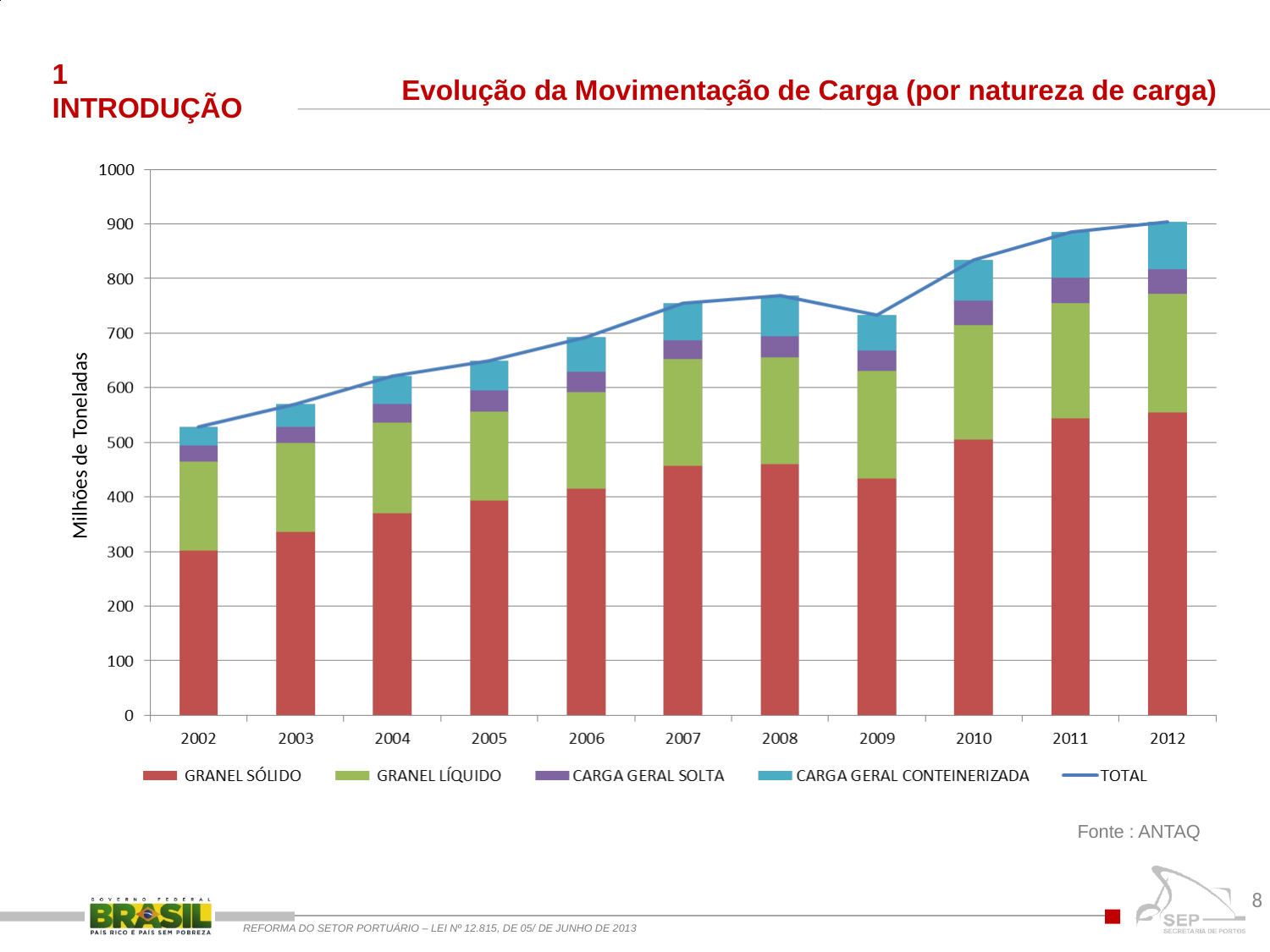
Is the TOTAL value for 2010 greater or less than 800? greater Is the TOTAL value for 2009 greater or less than 800? less How many series does the chart legend list? 5 In which year is the TOTAL line at its highest? 2012 Which year has the larger TOTAL value, 2008 or 2009? 2008 Is the TOTAL value for 2002 greater or less than 500? greater In which year is the TOTAL line at its lowest? 2002 Does the TOTAL line generally rise or fall from 2002 to 2012? rise How many years are shown on the x axis of the chart? 11 What is the label on the vertical axis of the chart? Milhões de Toneladas What kind of chart is shown on the slide? Stacked bar chart with a line for the total